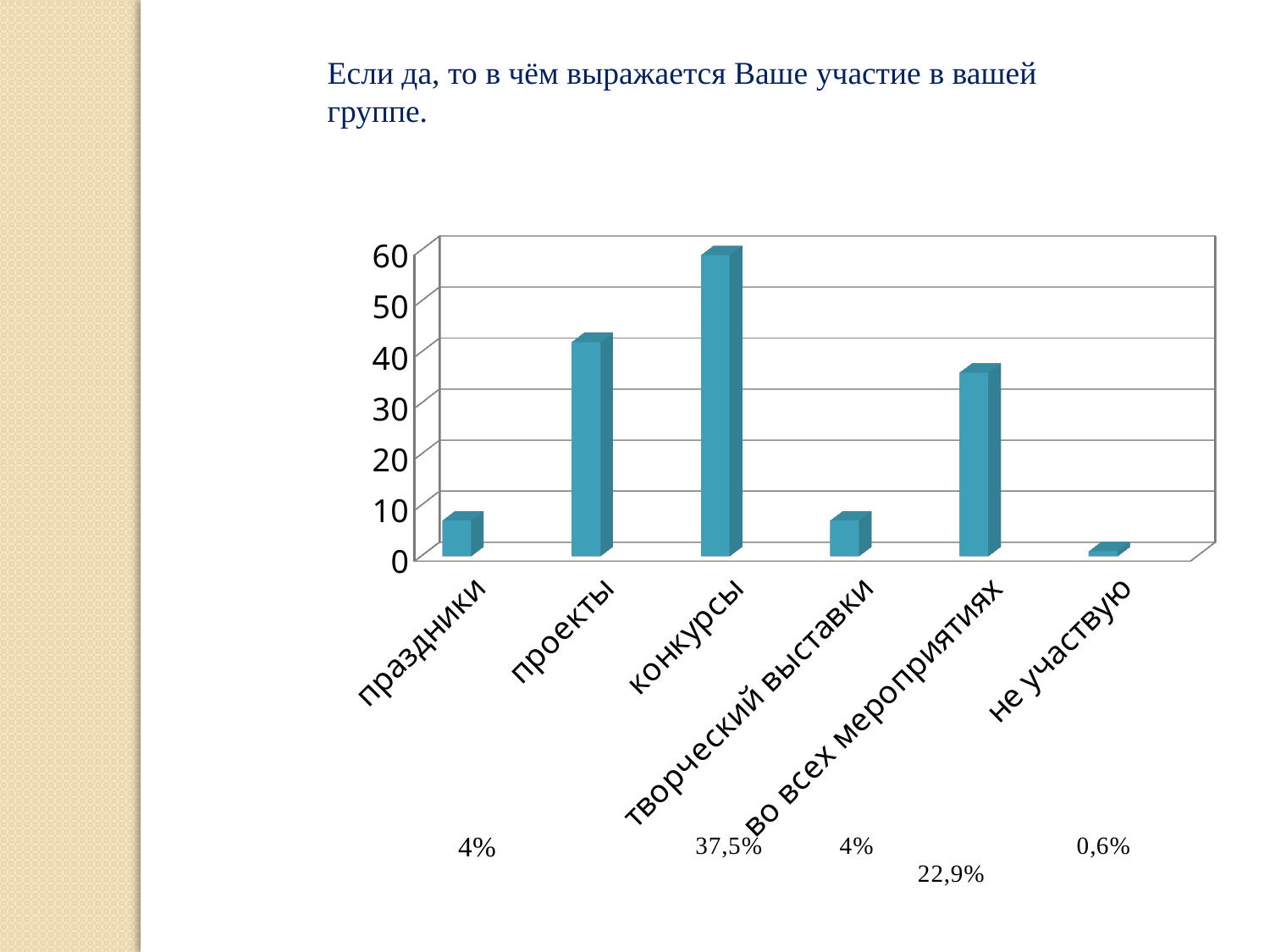
Which category has the lowest bar? не участвую How many categories are shown on the x axis of the chart? 6 Is the value for во всех мероприятиях greater or less than 30? greater What is the highest value shown on the vertical axis of the chart? 60 Is the value for праздники greater or less than 10? less Is the value for не участвую greater or less than 10? less Which category has the highest bar? конкурсы Which is larger, the bar for конкурсы or the bar for проекты? конкурсы Which is larger, the bar for проекты or the bar for во всех мероприятиях? проекты What kind of chart is shown on the slide? bar chart